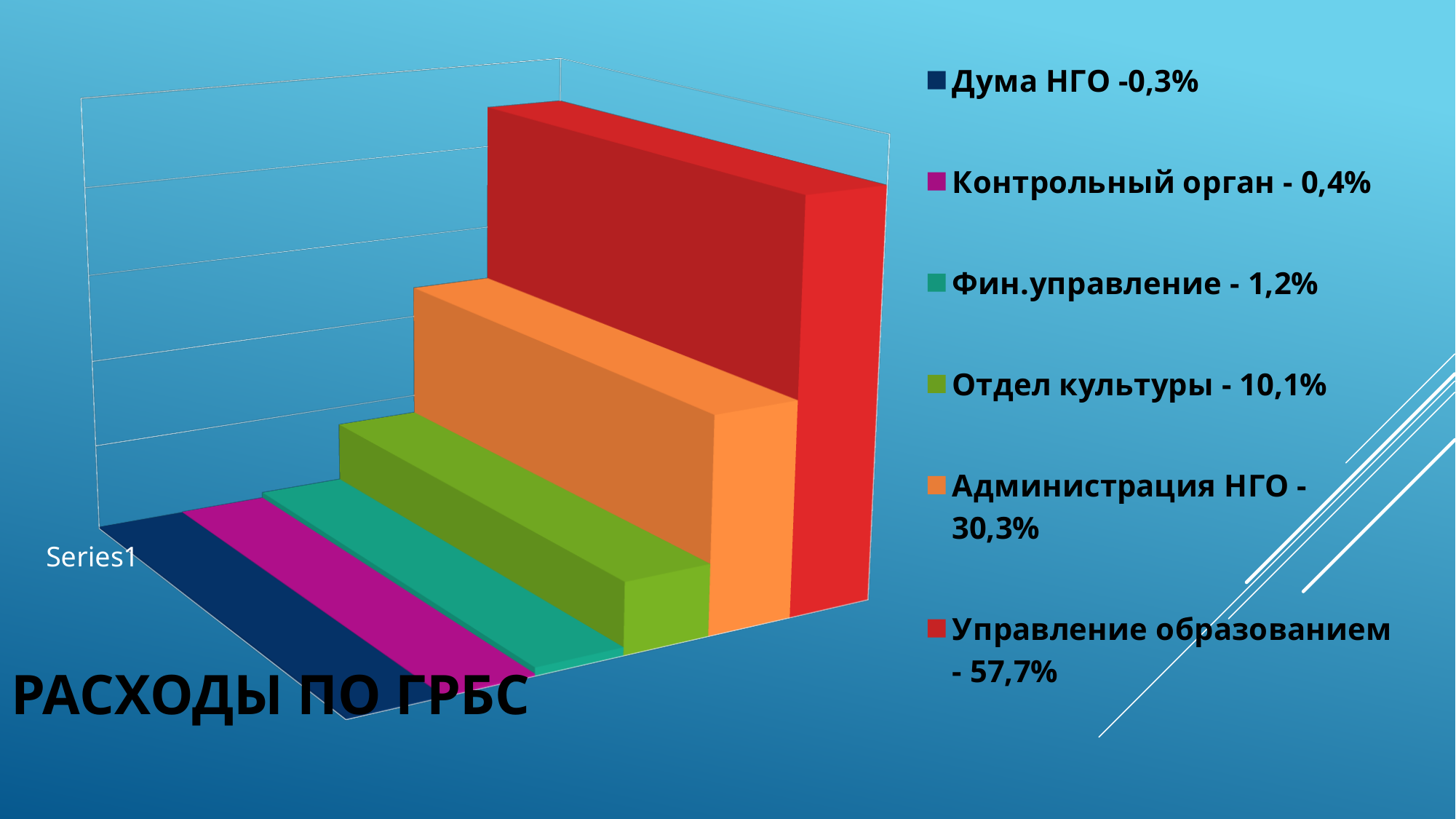
What is the difference between the values for Управление образованием and Администрация НГО? 27,4% What is the value for Администрация НГО? 30,3% Which is larger, the value for Отдел культуры or the value for Контрольный орган? Отдел культуры What is the value for Дума НГО? 0,3% What is the value for Отдел культуры? 10,1% What kind of chart is shown on the slide? bar chart What is the value for Управление образованием? 57,7% How many categories does the legend list? 6 What is the title of the chart on the slide? РАСХОДЫ ПО ГРБС What is the value for Фин.управление? 1,2% Which category has the highest value? Управление образованием Which category has the lowest value? Дума НГО